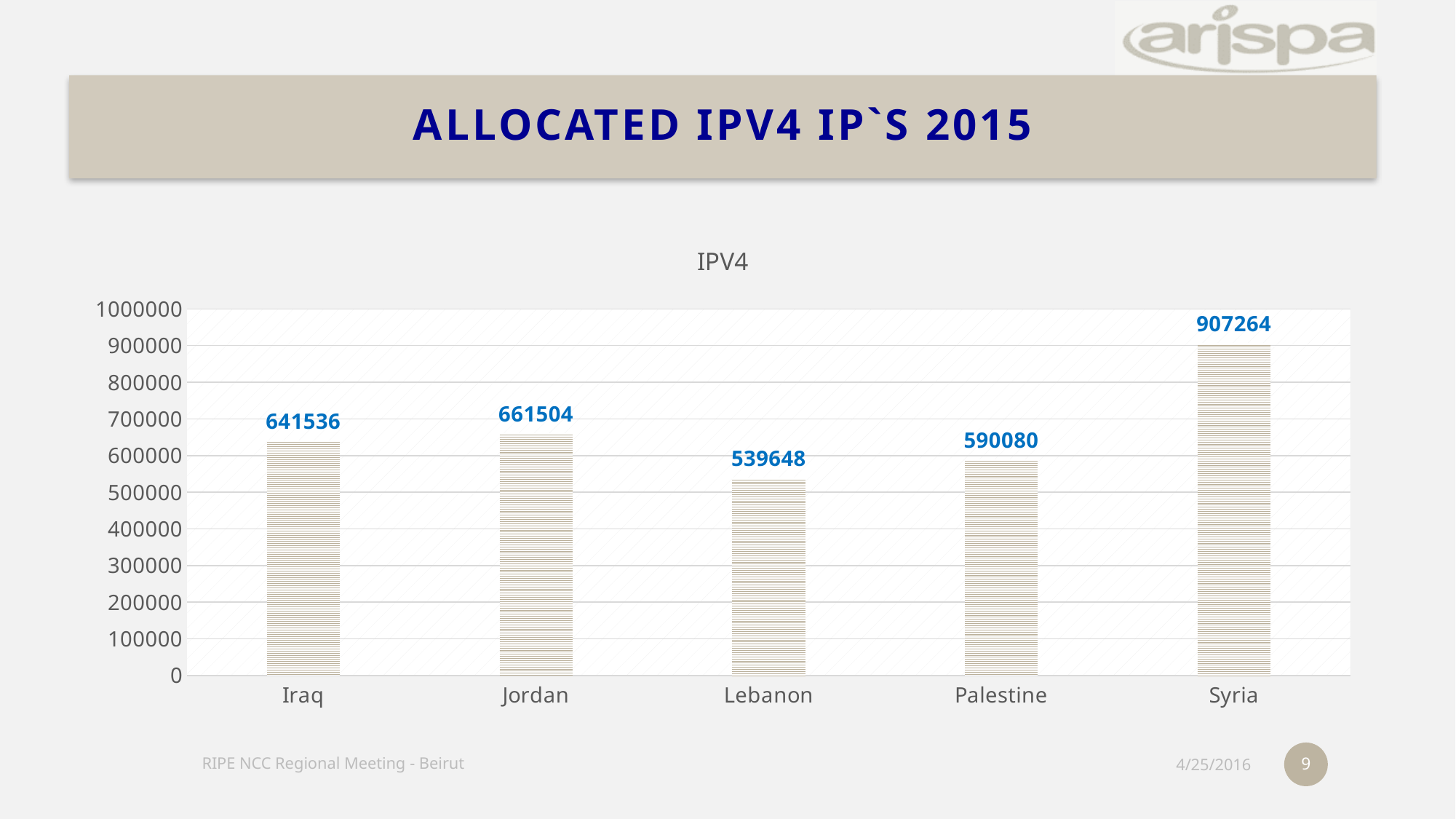
What is the value for Syria? 907264 How many countries are shown on the chart? 5 What is the value for Iraq? 641536 What kind of chart is shown on the slide? bar chart What is the difference between the values for Syria and Jordan? 245760 Which country has the highest allocated IPv4 value? Syria Which is larger, the value for Jordan or the value for Iraq? Jordan What is the difference between the values for Palestine and Lebanon? 50432 What is the title of the chart? IPV4 Which country has the lowest allocated IPv4 value? Lebanon Is the value for Palestine greater or less than 600000? less What is the value for Lebanon? 539648